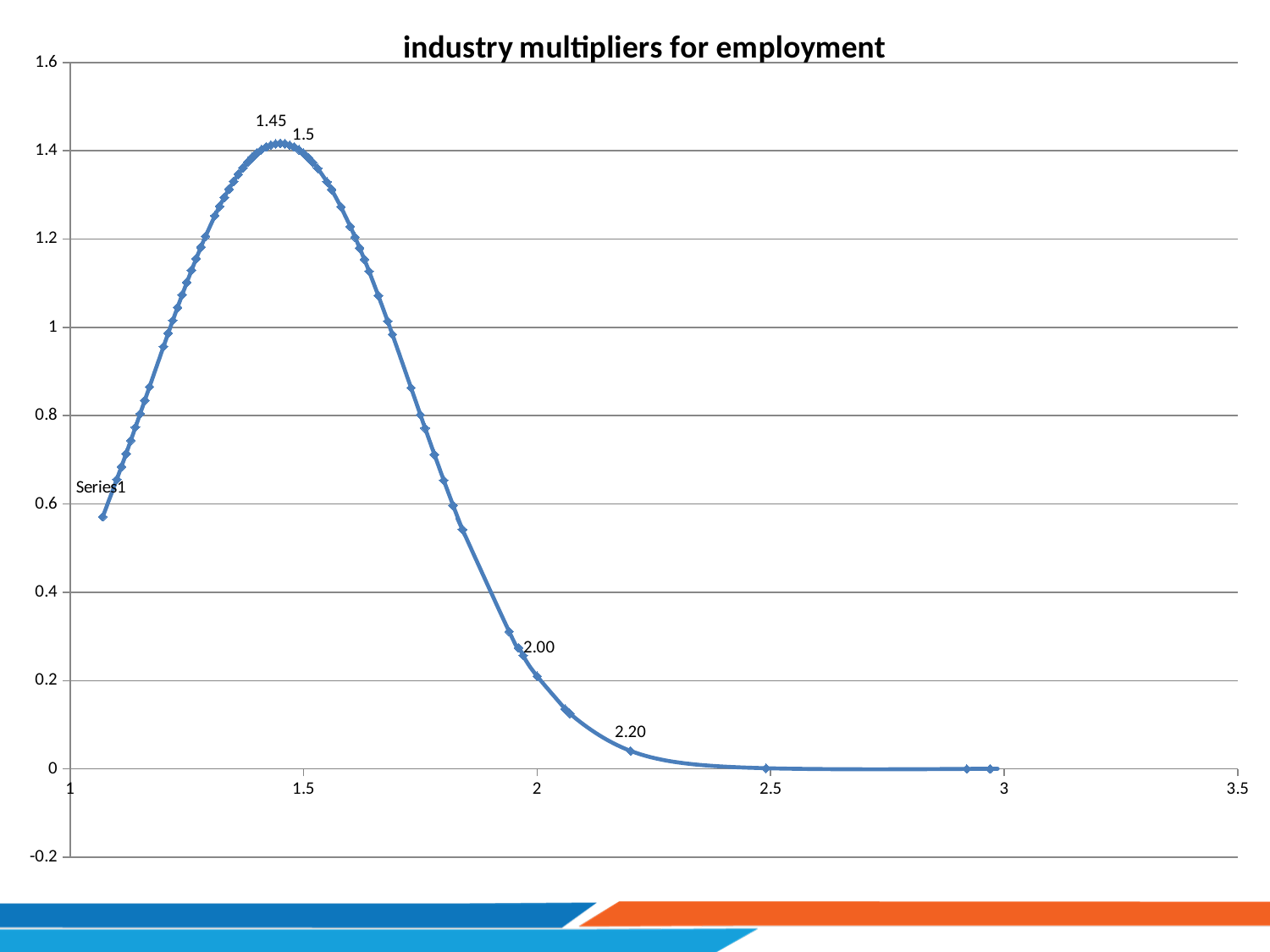
How many series does the chart plot? 1 Which labelled point has the highest value on the chart? 1.45 What kind of chart is shown on the slide? line chart Is the value at the point labelled 2.20 greater or less than 0.2? less Which has the larger value, the point labelled 2.00 or the point labelled 2.20? 2.00 Is the value at x = 2.5 greater or less than 0.2? less Is the value at the point labelled 2.00 greater or less than 0.4? less What is the title of the chart? industry multipliers for employment Does the curve rise or fall as x increases from 1.5 to 2.5? fall